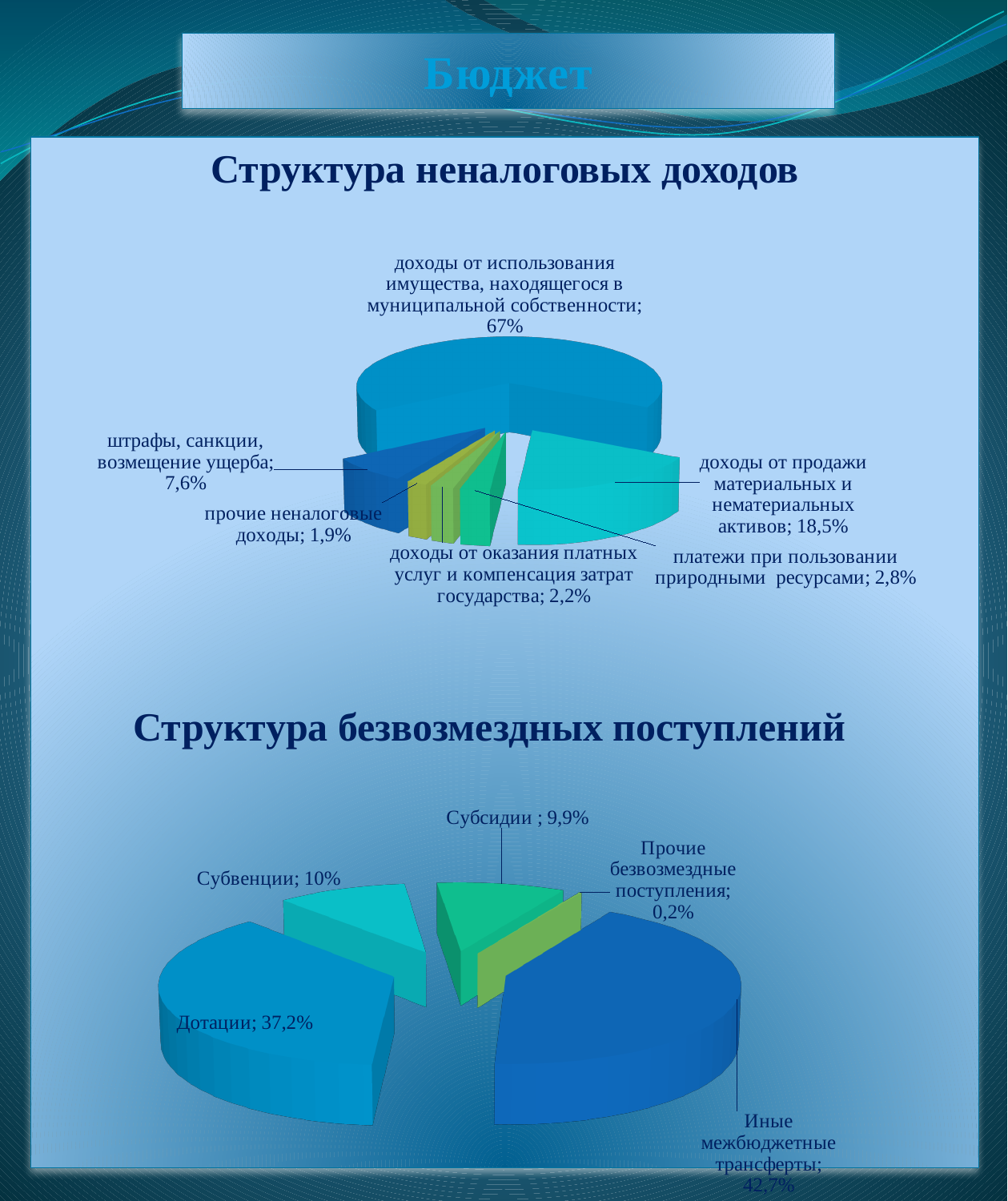
What kind of chart is 'Структура безвозмездных поступлений'? pie chart In the chart 'Структура безвозмездных поступлений', what is the difference between the shares of 'Иные межбюджетные трансферты' and 'Дотации'? 5,5% In the chart 'Структура неналоговых доходов', what share is shown for 'доходы от использования имущества, находящегося в муниципальной собственности'? 67% In the chart 'Структура неналоговых доходов', which category has the smallest share? прочие неналоговые доходы In the chart 'Структура неналоговых доходов', what share is shown for 'штрафы, санкции, возмещение ущерба'? 7,6% In the chart 'Структура безвозмездных поступлений', what share is shown for 'Прочие безвозмездные поступления'? 0,2% In the chart 'Структура безвозмездных поступлений', what share is shown for 'Дотации'? 37,2% In the chart 'Структура неналоговых доходов', what is the difference between the shares of 'доходы от продажи материальных и нематериальных активов' and 'штрафы, санкции, возмещение ущерба'? 10,9% In the chart 'Структура неналоговых доходов', how many categories are shown? 6 In the chart 'Структура безвозмездных поступлений', which category has the largest share? Иные межбюджетные трансферты In the chart 'Структура неналоговых доходов', which is larger: 'платежи при пользовании природными ресурсами' or 'доходы от оказания платных услуг и компенсация затрат государства'? платежи при пользовании природными ресурсами In the chart 'Структура безвозмездных поступлений', how many categories are shown? 5